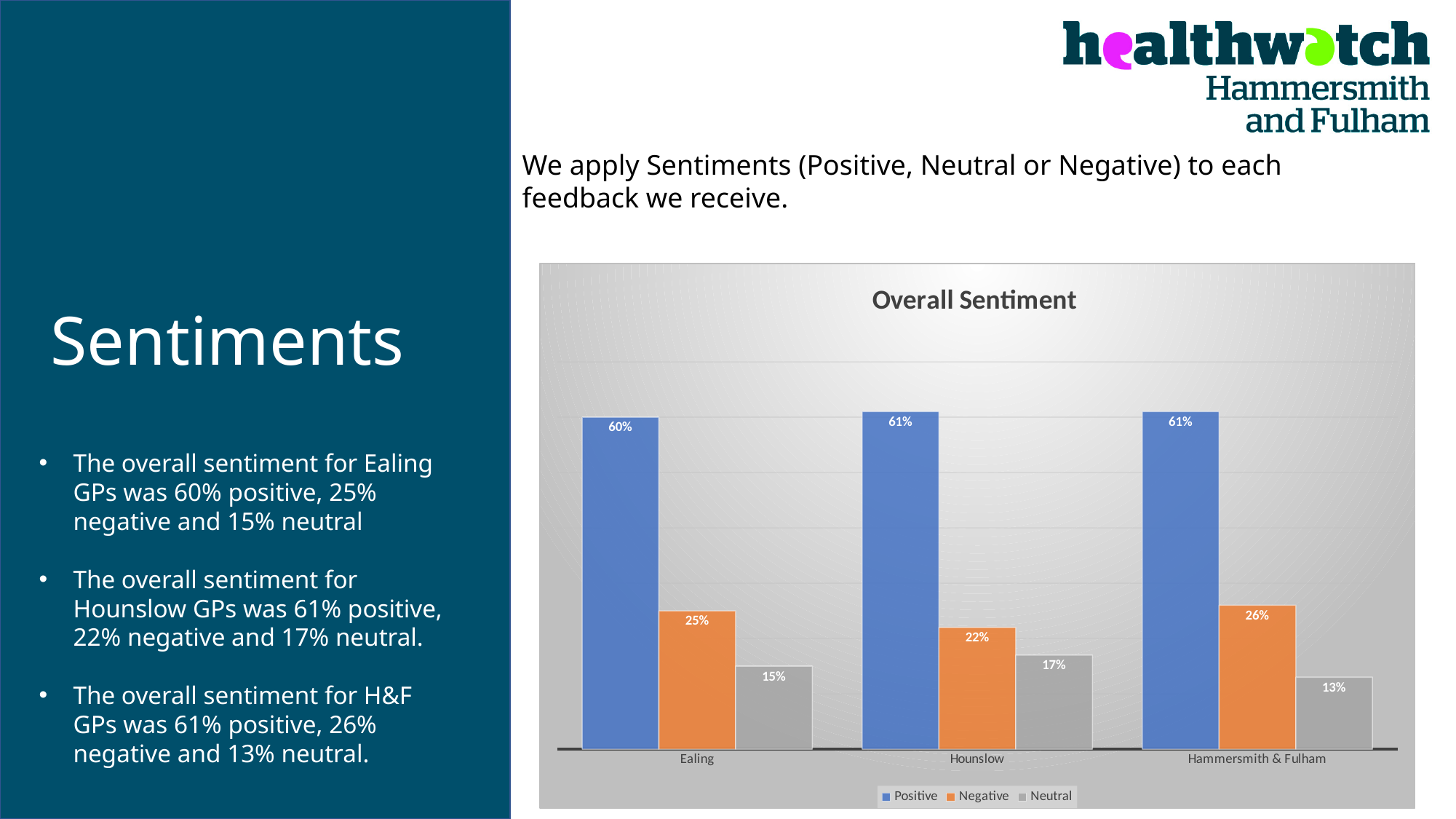
How many categories are shown on the x axis of the Overall Sentiment chart? 3 What is the Positive value for Ealing in the Overall Sentiment chart? 60% Which category has the highest Negative value in the Overall Sentiment chart? Hammersmith & Fulham What is the Neutral value for Hounslow in the Overall Sentiment chart? 17% Is the Negative value for Ealing larger or smaller than the Negative value for Hounslow in the Overall Sentiment chart? larger Which category has the lowest Neutral value in the Overall Sentiment chart? Hammersmith & Fulham What is the difference between the Negative values for Ealing and Hounslow in the Overall Sentiment chart? 3% What is the Negative value for Hammersmith & Fulham in the Overall Sentiment chart? 26% What is the title of the chart on the slide? Overall Sentiment How many series does the legend of the Overall Sentiment chart list? 3 Which colour represents the Negative series in the Overall Sentiment chart? Orange What kind of chart is the Overall Sentiment chart? Bar chart